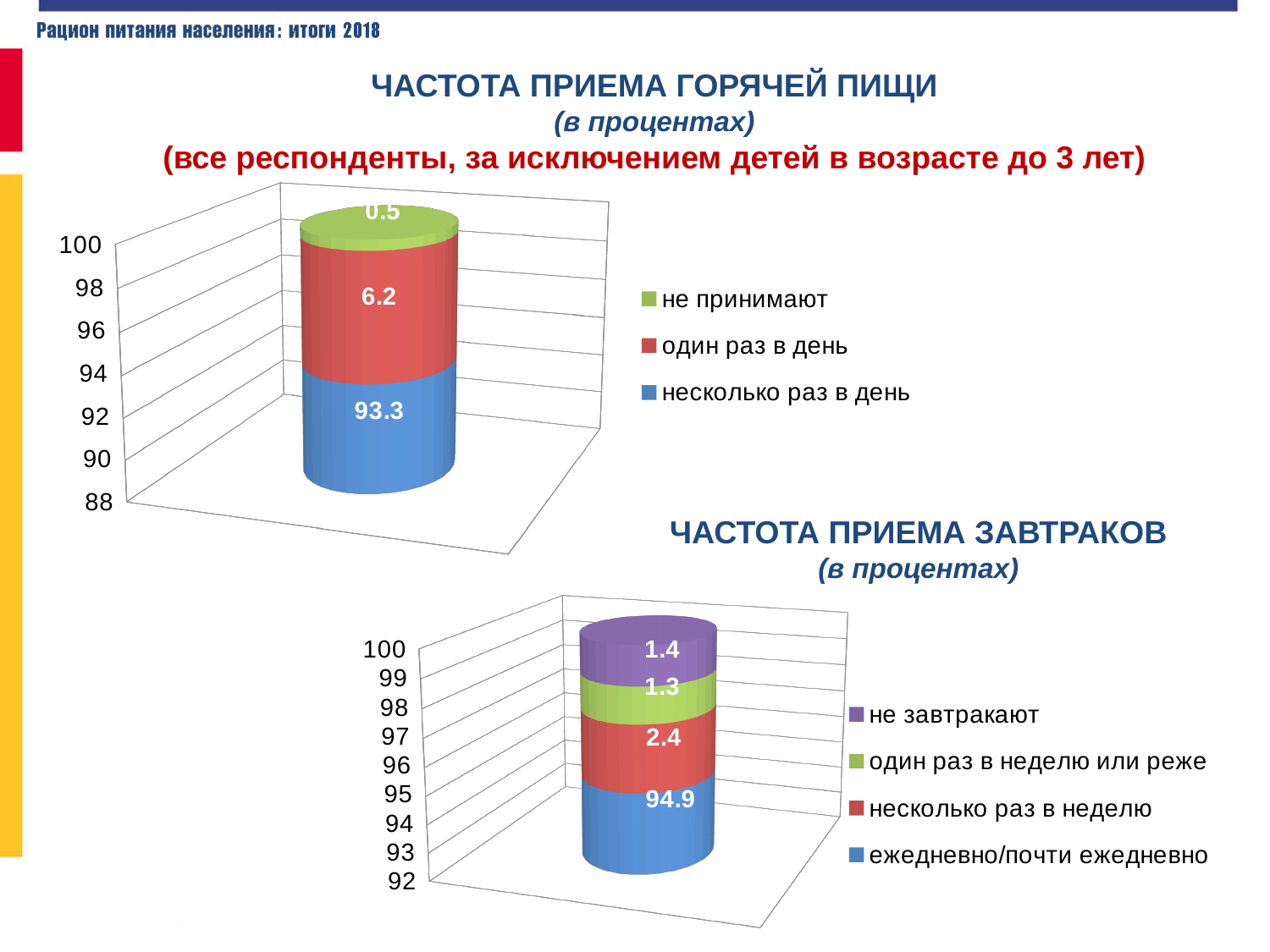
In the chart 'ЧАСТОТА ПРИЕМА ГОРЯЧЕЙ ПИЩИ', what is the difference between 'один раз в день' and 'не принимают'? 5.7 In the chart 'ЧАСТОТА ПРИЕМА ЗАВТРАКОВ', what is the value for 'не завтракают'? 1.4 What kind of chart is 'ЧАСТОТА ПРИЕМА ЗАВТРАКОВ'? stacked bar chart In the chart 'ЧАСТОТА ПРИЕМА ГОРЯЧЕЙ ПИЩИ', what is the value for 'один раз в день'? 6.2 In the chart 'ЧАСТОТА ПРИЕМА ЗАВТРАКОВ', what is the value for 'ежедневно/почти ежедневно'? 94.9 In the chart 'ЧАСТОТА ПРИЕМА ЗАВТРАКОВ', what is the total of the stacked bar? 100 How many series does the legend of the chart 'ЧАСТОТА ПРИЕМА ГОРЯЧЕЙ ПИЩИ' list? 3 In the chart 'ЧАСТОТА ПРИЕМА ГОРЯЧЕЙ ПИЩИ', which series has the largest value? несколько раз в день In the chart 'ЧАСТОТА ПРИЕМА ГОРЯЧЕЙ ПИЩИ', what is the value for 'не принимают'? 0.5 In the chart 'ЧАСТОТА ПРИЕМА ГОРЯЧЕЙ ПИЩИ', what is the value for 'несколько раз в день'? 93.3 In the chart 'ЧАСТОТА ПРИЕМА ЗАВТРАКОВ', what is the value for 'несколько раз в неделю'? 2.4 In the chart 'ЧАСТОТА ПРИЕМА ЗАВТРАКОВ', which series has the smallest value? один раз в неделю или реже